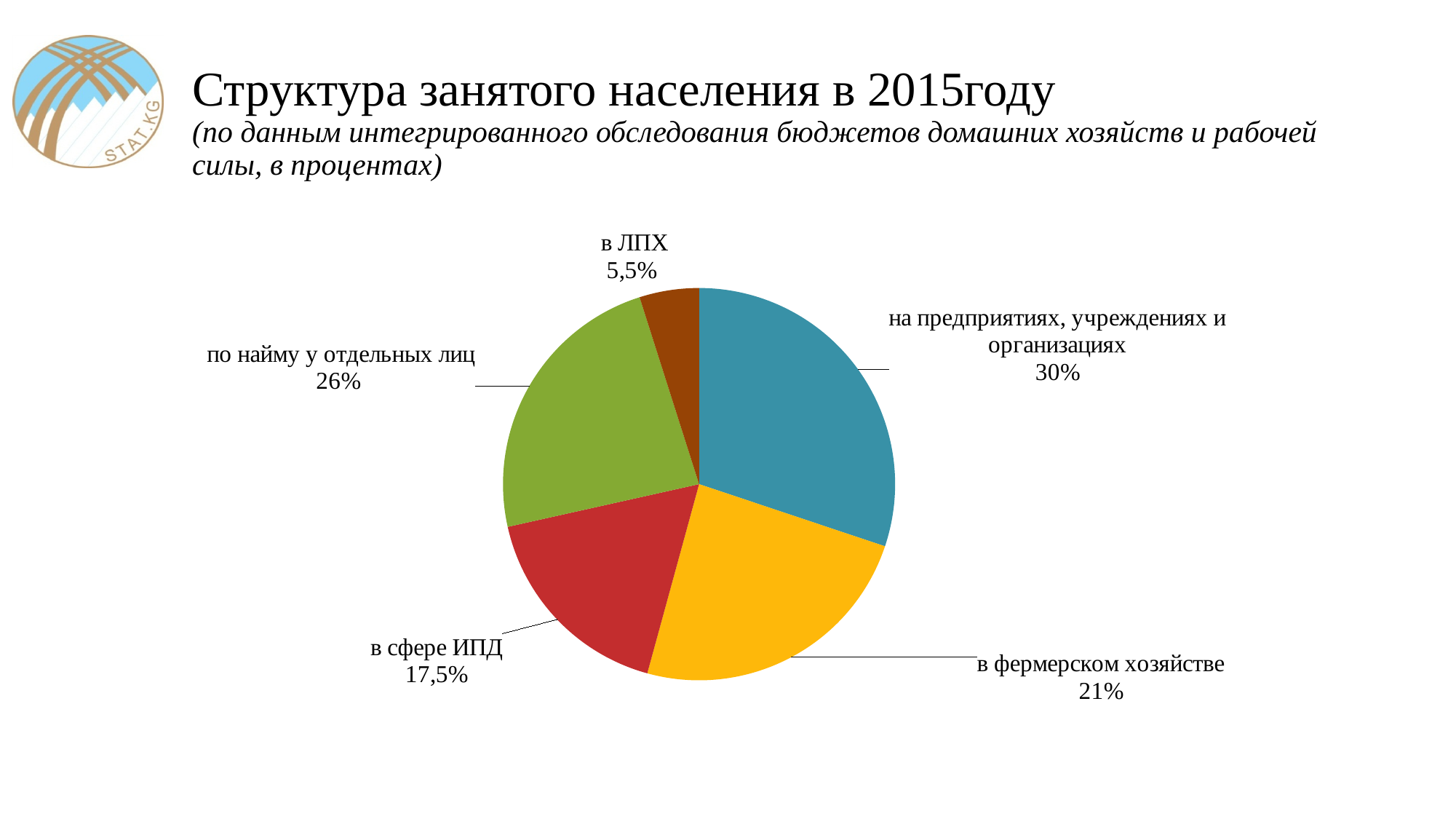
What colour is the slice for в фермерском хозяйстве? yellow Which category has the smallest share of the pie? в ЛПХ Which is larger: the share for в фермерском хозяйстве or the share for в сфере ИПД? в фермерском хозяйстве Which category has the largest share of the pie? на предприятиях, учреждениях и организациях What is the difference in percentage points between по найму у отдельных лиц and в фермерском хозяйстве? 5 How many slices does the pie chart have? 5 What share is shown for в сфере ИПД? 17,5% What type of chart is shown on the slide? pie chart What share is shown for в фермерском хозяйстве? 21% What share of the employed population works на предприятиях, учреждениях и организациях? 30% What share is shown for по найму у отдельных лиц? 26% What share is shown for в ЛПХ? 5,5%